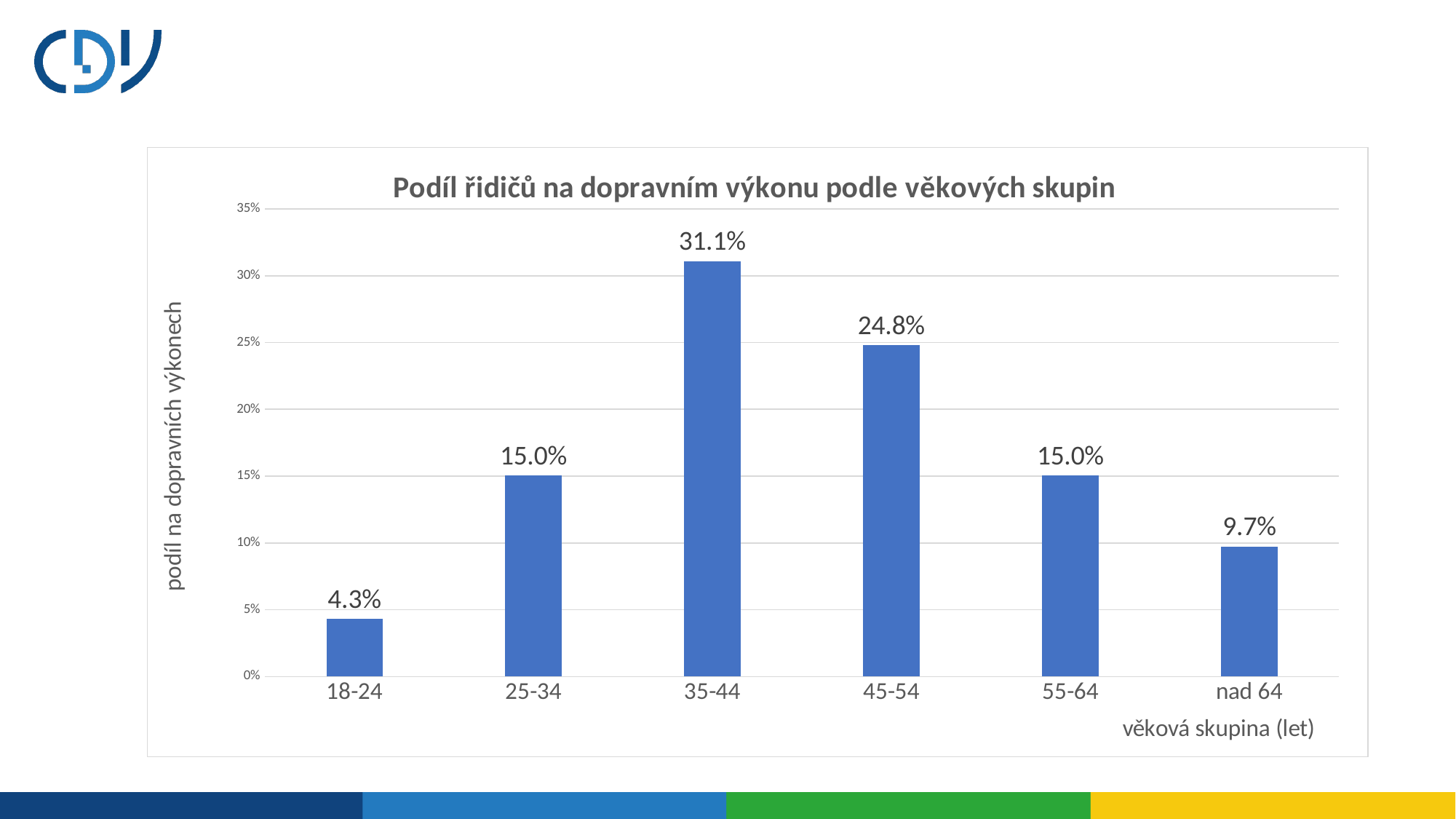
What is the value for the 35-44 age group? 31.1% Which age group has the lowest share? 18-24 What is the difference between the values for 35-44 and 45-54? 6.3% What is the title of the chart? Podíl řidičů na dopravním výkonu podle věkových skupin Which is larger, the value for 45-54 or the value for 55-64? 45-54 How many age groups are shown on the x axis? 6 What kind of chart is shown on the slide? bar chart Which age group has the highest share? 35-44 What is the difference between the values for 25-34 and 18-24? 10.7% Is the value for 45-54 greater or less than 20%? greater What is the value for the 'nad 64' age group? 9.7% What is the value for the 18-24 age group? 4.3%